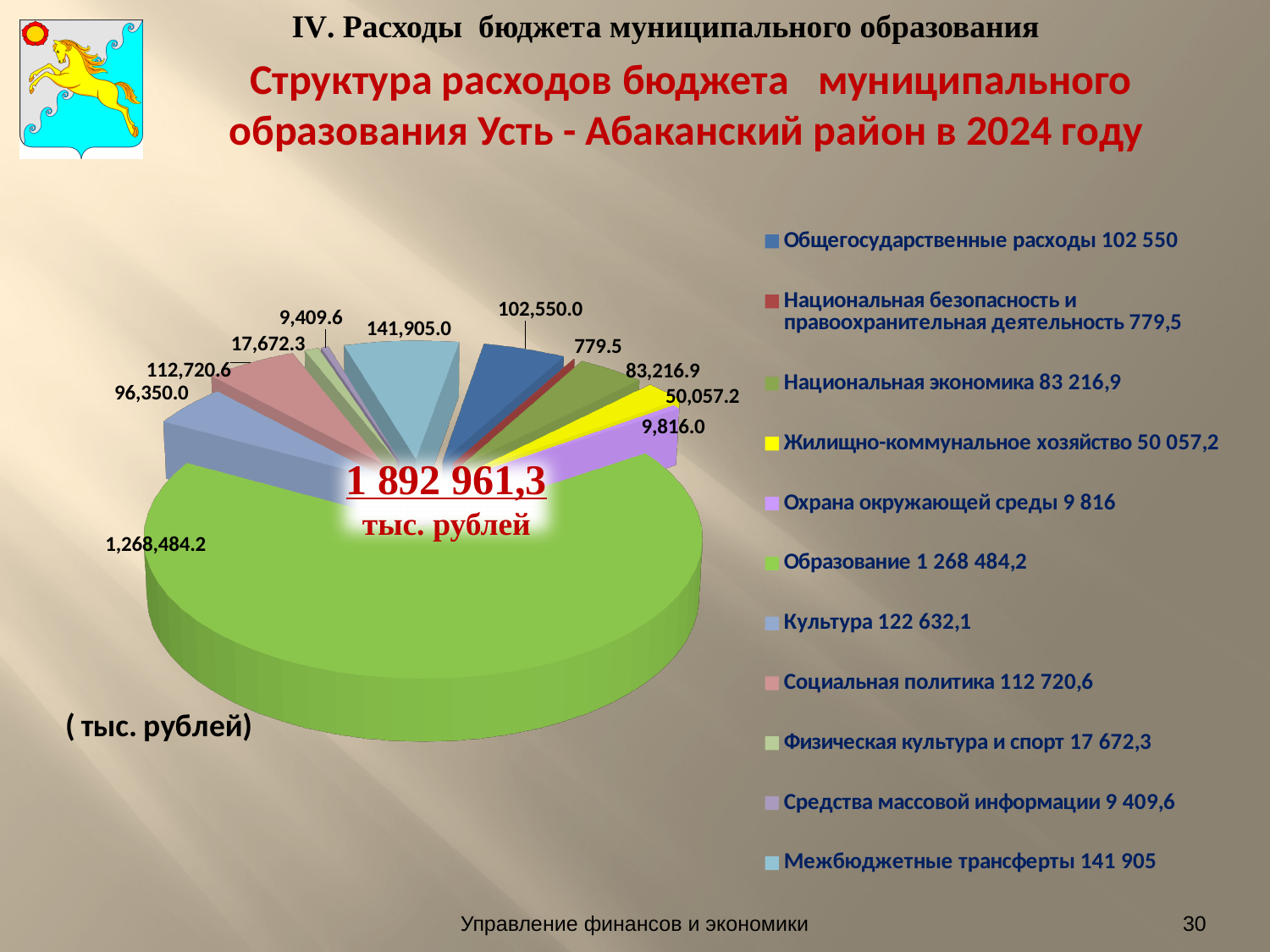
How many entries does the legend of the pie chart list? 11 What type of chart is shown on the slide? pie chart What value is labelled on the pie chart for Межбюджетные трансферты? 141,905.0 What value is labelled on the pie chart for Жилищно-коммунальное хозяйство? 50,057.2 What value is labelled on the pie chart for Социальная политика? 112,720.6 What is the difference between Общегосударственные расходы (102,550.0) and Национальная экономика (83,216.9)? 19,333.1 How many categories (slices) does the pie chart show? 11 Which is larger: Общегосударственные расходы or Национальная экономика? Общегосударственные расходы What total amount is printed in the centre of the pie chart? 1 892 961,3 тыс. рублей Which category has the smallest slice in the pie chart? Национальная безопасность и правоохранительная деятельность Which category has the largest slice in the pie chart? Образование What value is labelled on the pie chart for Образование? 1,268,484.2